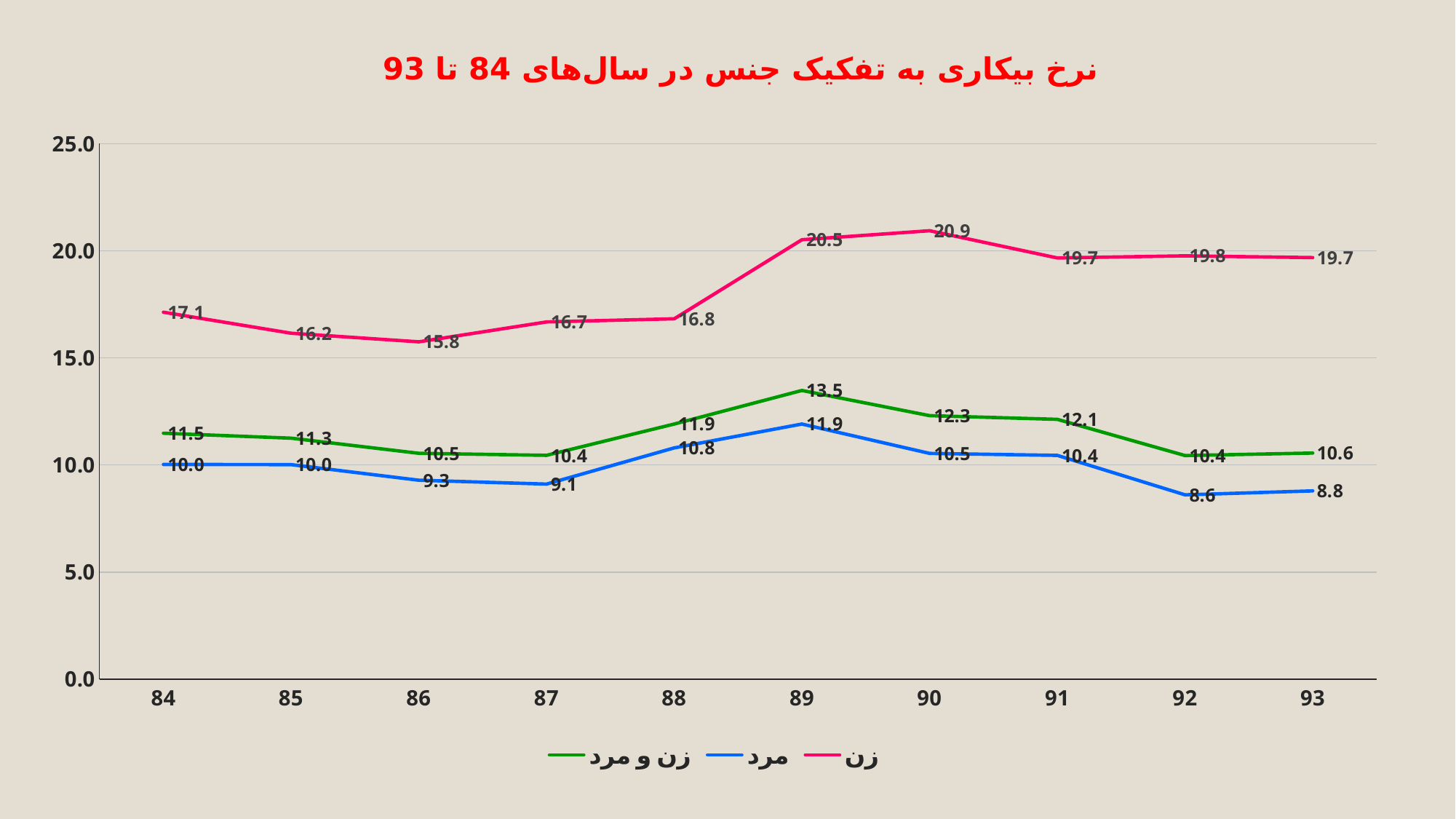
What is the difference between the زن (women) value and the مرد (men) value in year 93? 10.9 How many years are plotted along the x axis? 10 In which year does the زن (women) series reach its highest value? 90 What is the value for the مرد (men) series in year 92? 8.6 What is the value for the زن (women) series in year 90? 20.9 How many series does the legend list? 3 What is the value for the زن و مرد (both) series in year 89? 13.5 What colour is the line for the مرد (men) series? blue In which year does the مرد (men) series reach its lowest value? 92 Which series has the larger value in year 88, زن (women) or زن و مرد (both)? زن Does the زن (women) series rise or fall from year 88 to year 89? rise What type of chart is shown on the slide? line chart